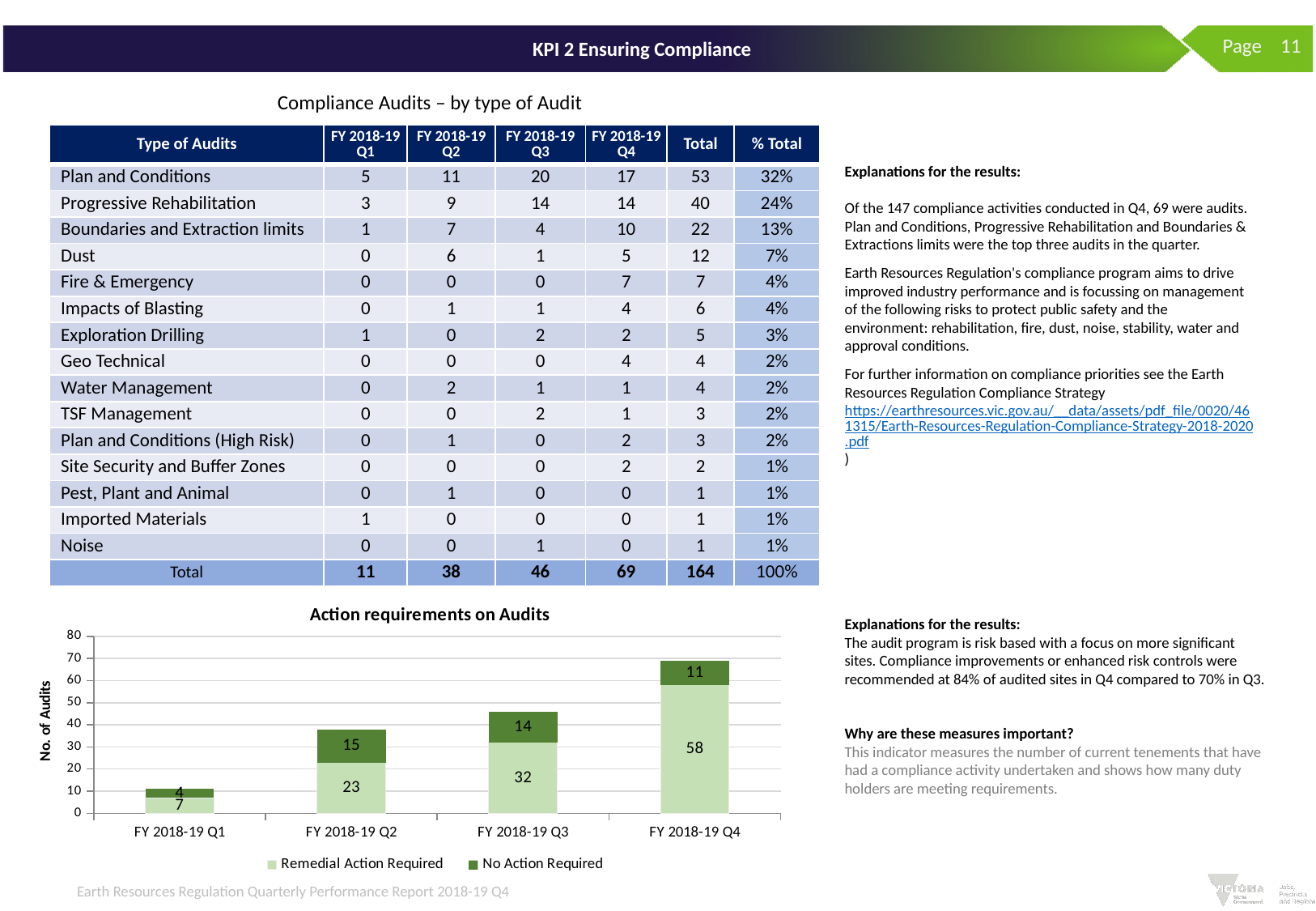
In the 'Action requirements on Audits' chart, what is the value for Remedial Action Required in FY 2018-19 Q4? 58 What type of chart is 'Action requirements on Audits'? stacked bar chart In the 'Action requirements on Audits' chart, what is the value for No Action Required in FY 2018-19 Q2? 15 In the 'Action requirements on Audits' chart, what is the total height of the stacked bar for FY 2018-19 Q4? 69 In the 'Action requirements on Audits' chart, what is the value for Remedial Action Required in FY 2018-19 Q1? 7 In the 'Action requirements on Audits' chart, which quarter has the lowest value for No Action Required? FY 2018-19 Q1 In the 'Action requirements on Audits' chart, what is the difference between Remedial Action Required in FY 2018-19 Q4 and FY 2018-19 Q3? 26 How many series does the legend of the 'Action requirements on Audits' chart list? 2 In the 'Action requirements on Audits' chart, which is larger: No Action Required in FY 2018-19 Q2 or in FY 2018-19 Q3? FY 2018-19 Q2 In the 'Action requirements on Audits' chart, what is the total height of the stacked bar for FY 2018-19 Q3? 46 In the 'Action requirements on Audits' chart, which quarter has the highest value for Remedial Action Required? FY 2018-19 Q4 How many quarters are shown on the x axis of the 'Action requirements on Audits' chart? 4